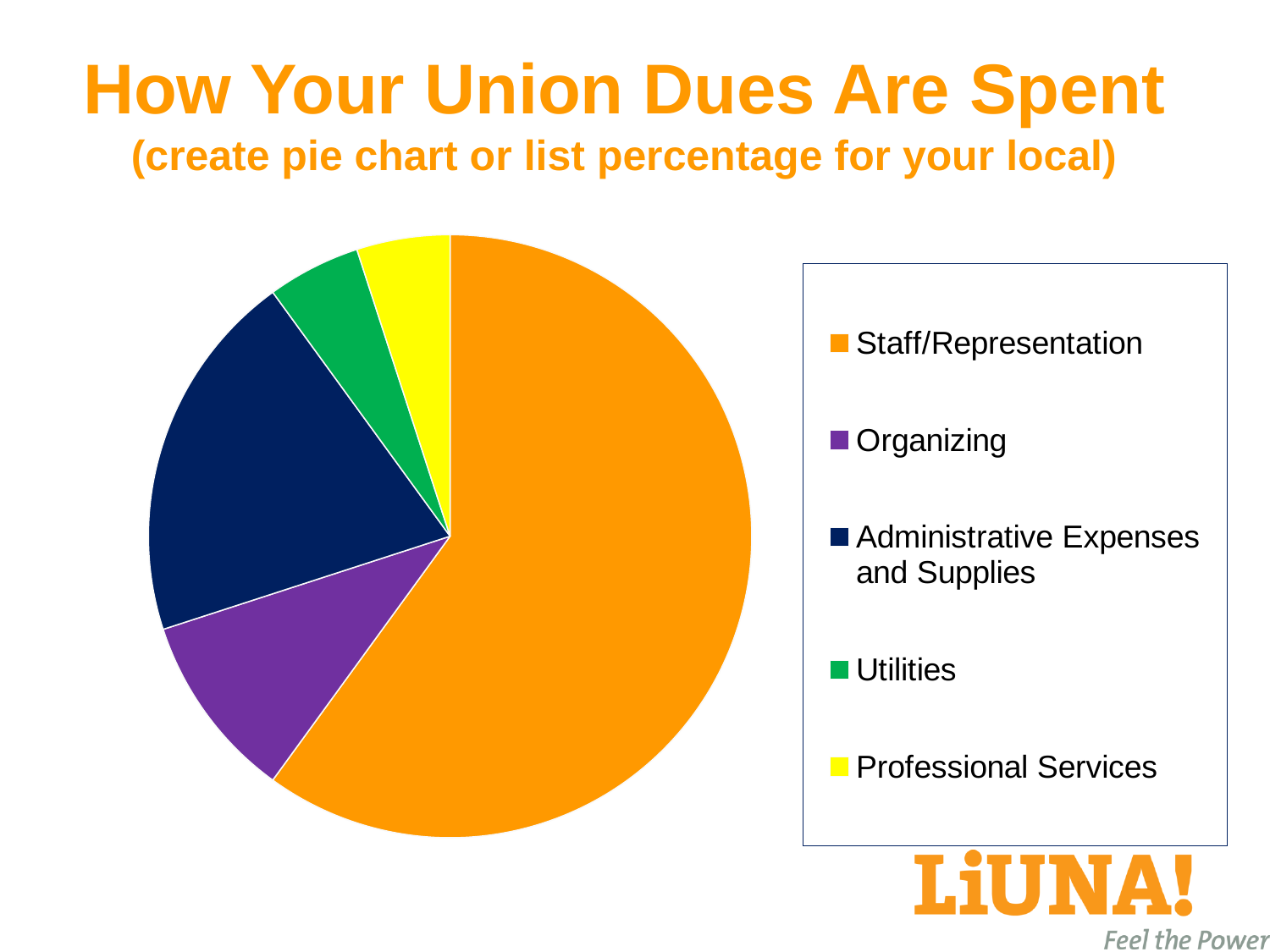
What kind of chart is shown on the slide? pie chart What is the title of the slide containing the pie chart? How Your Union Dues Are Spent How many entries does the legend list? 5 Which slice is larger, Staff/Representation or Organizing? Staff/Representation Which slice is larger, Staff/Representation or Administrative Expenses and Supplies? Staff/Representation Which category has the largest slice of the pie? Staff/Representation Which slice is larger, Administrative Expenses and Supplies or Organizing? Administrative Expenses and Supplies What colour is the Utilities slice in the pie chart? green How many slices does the pie chart have? 5